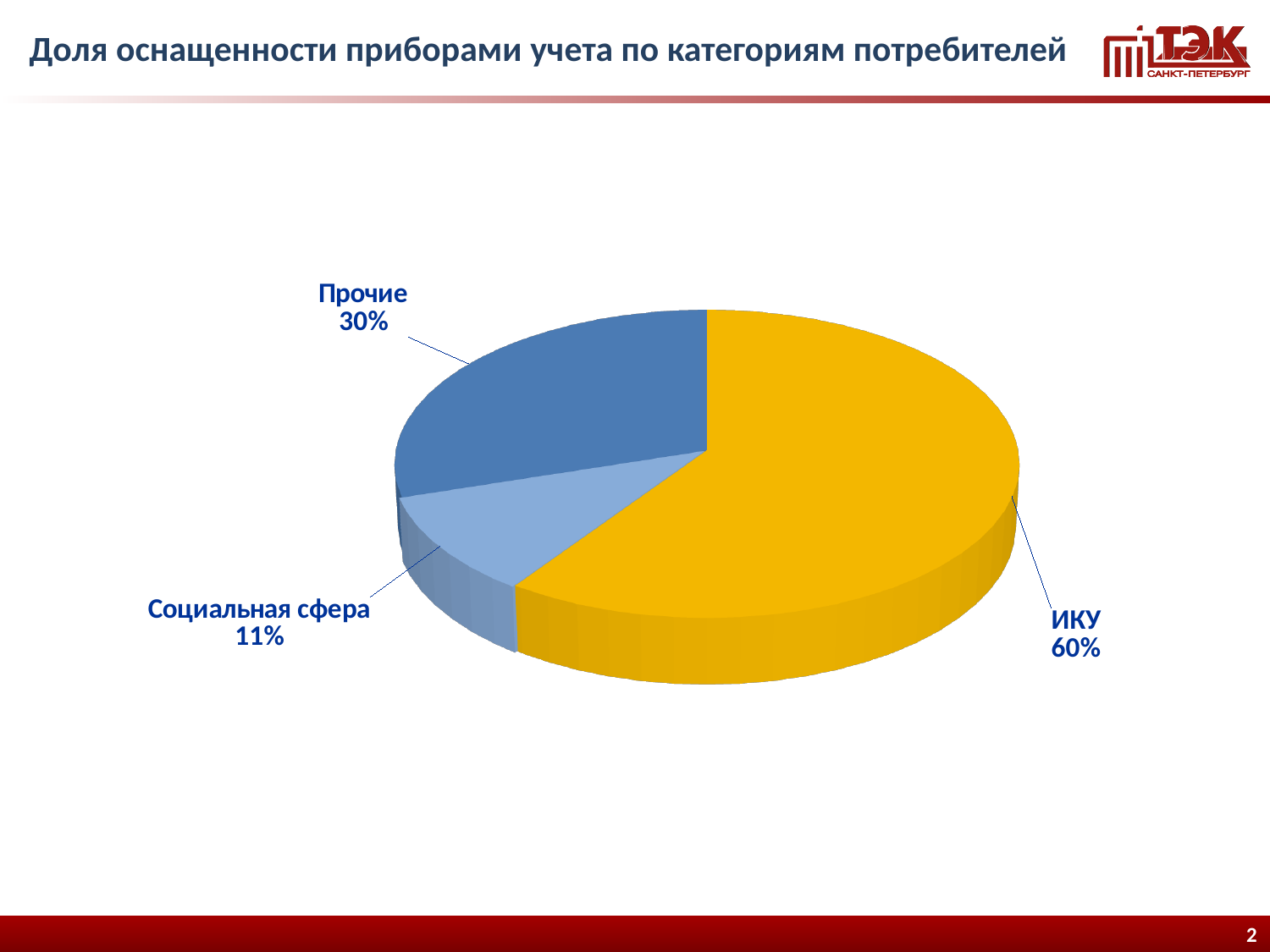
Which slice is larger, Прочие or Социальная сфера? Прочие Which category has the smallest share of the pie? Социальная сфера Which category has the largest share of the pie? ИКУ How many slices does the pie chart have? 3 What type of chart is shown on the slide? pie chart What share of the pie does Социальная сфера have? 11% What is the difference in percentage points between the ИКУ and Прочие slices? 30 What colour is the ИКУ slice of the pie? yellow What is the difference in percentage points between the Прочие and Социальная сфера slices? 19 What share of the pie does ИКУ have? 60% What is the title of the chart on the slide? Доля оснащенности приборами учета по категориям потребителей What share of the pie does Прочие have? 30%